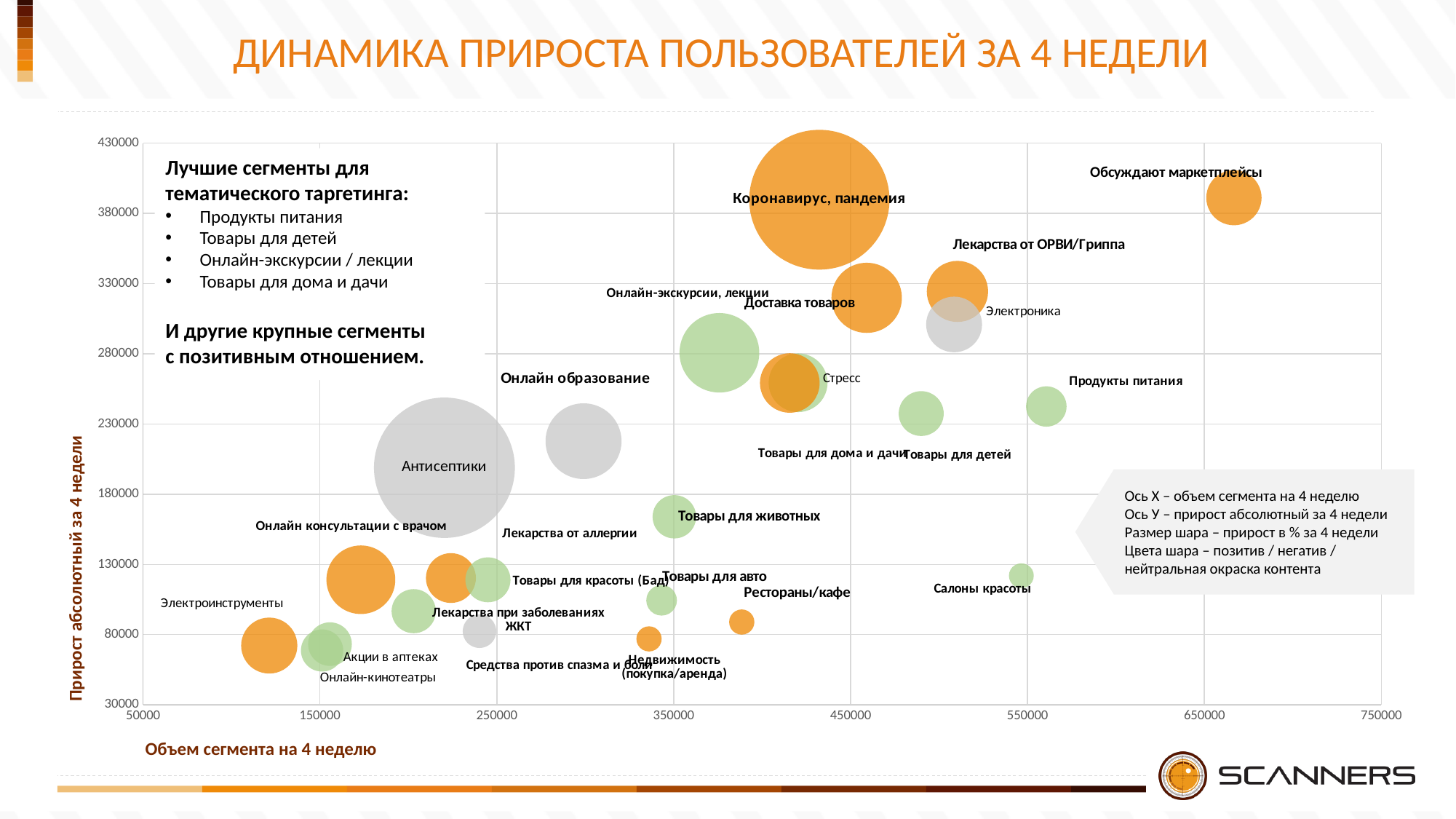
Is the x-axis value for Электроинструменты greater or less than 150000? less What kind of chart is shown on the slide? Bubble chart What is the title of the chart's x axis? Объем сегмента на 4 неделю Which segment is positioned furthest to the left on the x axis (smallest segment volume)? Электроинструменты Is the y-axis value for Антисептики greater or less than 230000? less Is the y-axis value for Коронавирус, пандемия greater or less than 330000? greater Which segment has the largest bubble on the chart? Коронавирус, пандемия What is the title of the chart's y axis? Прирост абсолютный за 4 недели Which segment is positioned furthest to the right on the x axis (largest segment volume)? Обсуждают маркетплейсы Which segment has the higher y-axis value, Коронавирус, пандемия or Антисептики? Коронавирус, пандемия